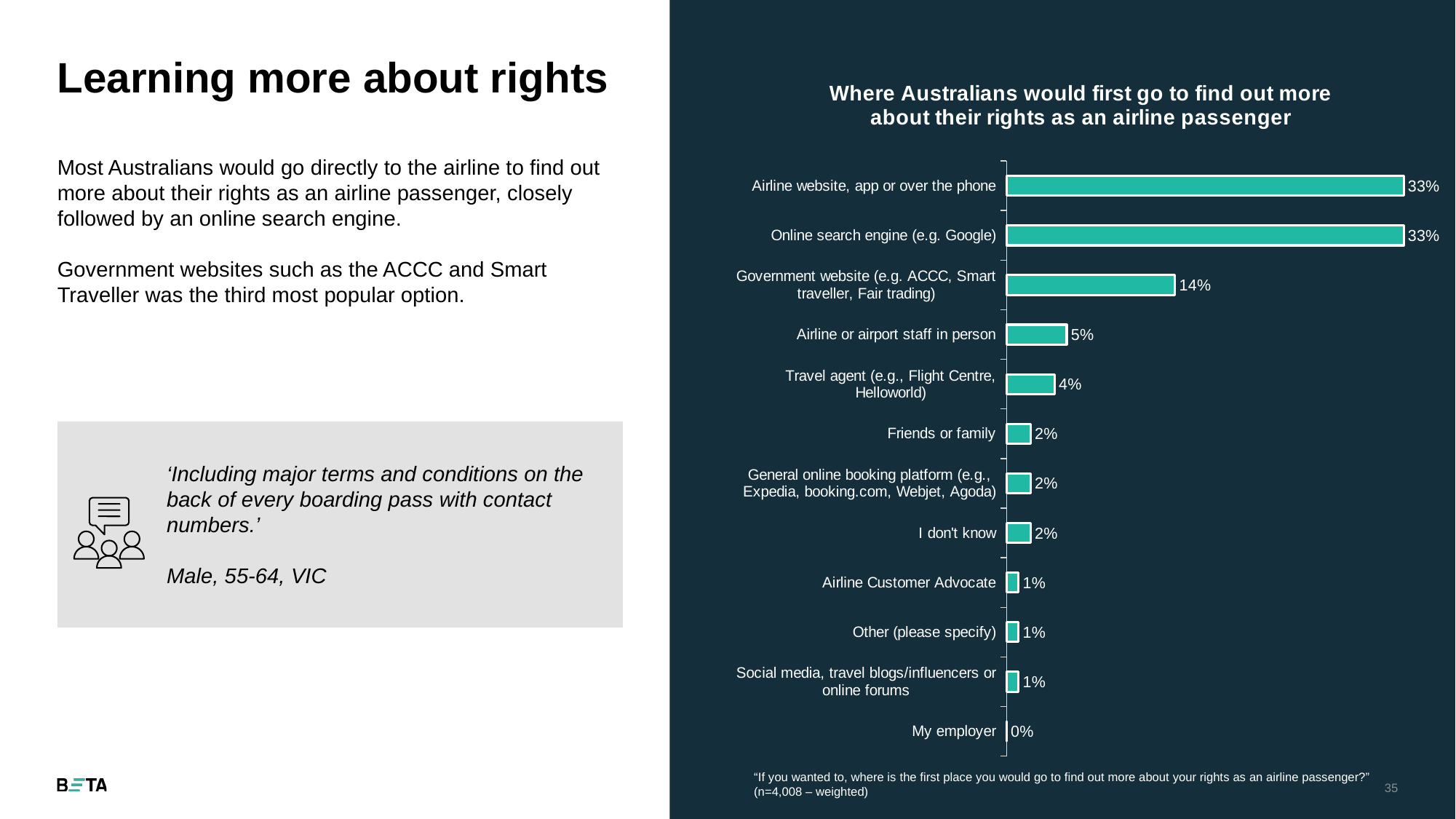
What percentage of Australians would first go to a government website (e.g. ACCC, Smart traveller, Fair trading) to find out more about their rights as an airline passenger? 14% Which has a higher value: 'Friends or family' or 'Airline Customer Advocate'? Friends or family What is the difference between the value for 'Government website' and the value for 'Airline or airport staff in person'? 9 percentage points What value is shown for 'Airline or airport staff in person'? 5% What percentage is shown for 'Travel agent (e.g., Flight Centre, Helloworld)'? 4% How many categories are shown in the chart? 12 What kind of chart is shown on the slide? Bar chart Which category has the lowest value in the chart? My employer What is the title of the chart? Where Australians would first go to find out more about their rights as an airline passenger Which has a higher value: 'Airline or airport staff in person' or 'Travel agent (e.g., Flight Centre, Helloworld)'? Airline or airport staff in person What is the difference between the value for 'Airline website, app or over the phone' and the value for 'Government website (e.g. ACCC, Smart traveller, Fair trading)'? 19 percentage points What value is shown for 'Online search engine (e.g. Google)'? 33%